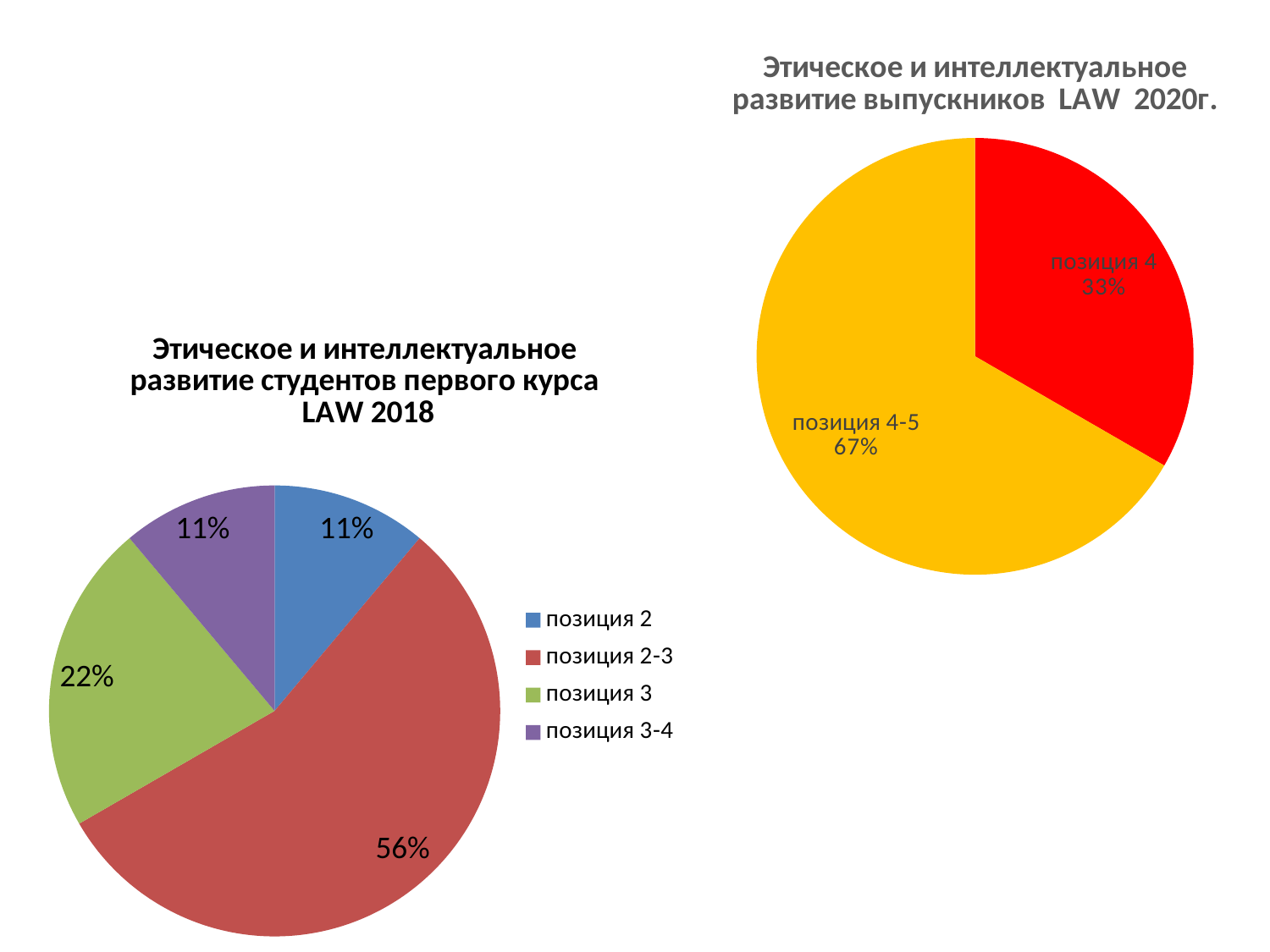
In the LAW 2018 chart on the left, which is larger: the share of позиция 3 or the share of позиция 3-4? позиция 3 In the LAW 2018 chart on the left, what colour is the slice for позиция 3? green What kind of chart is the LAW 2018 chart on the left? pie chart In the LAW 2020 chart on the right, which category has the smallest share? позиция 4 In the LAW 2018 chart on the left, how many categories does the legend list? 4 In the LAW 2018 chart on the left, what share does позиция 3 have? 22% In the LAW 2020 chart on the right, what share does позиция 4-5 have? 67% In the LAW 2018 chart on the left, what is the difference between the shares of позиция 2-3 and позиция 3? 34% In the LAW 2020 chart on the right, how many slices does the pie have? 2 In the LAW 2018 chart on the left, what share does позиция 2-3 have? 56% In the LAW 2018 chart on the left, which category has the largest share? позиция 2-3 In the LAW 2020 chart on the right, what share does позиция 4 have? 33%